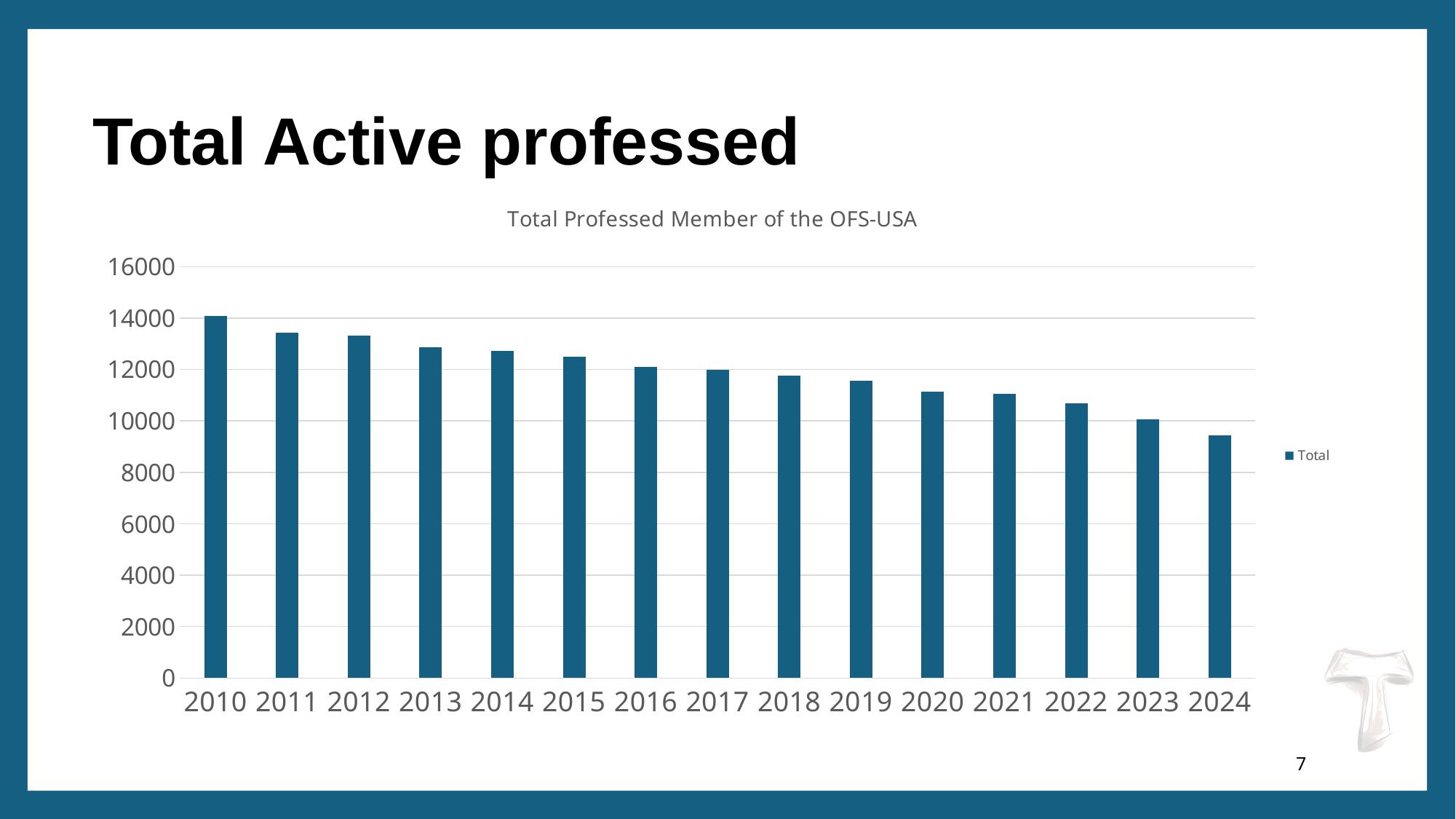
Which year has the lowest total? 2024 Which year has the highest total? 2010 Which is larger, the value for 2013 or the value for 2019? 2013 How many years are shown on the x axis? 15 Is the value for 2020 greater or less than 10000? greater Is the value for 2015 greater or less than 12000? greater Do the values rise or fall from 2010 to 2024? fall Is the value for 2024 greater or less than 10000? less What is the title of the chart? Total Professed Member of the OFS-USA What kind of chart is shown on the slide? bar chart How many series does the legend list? 1